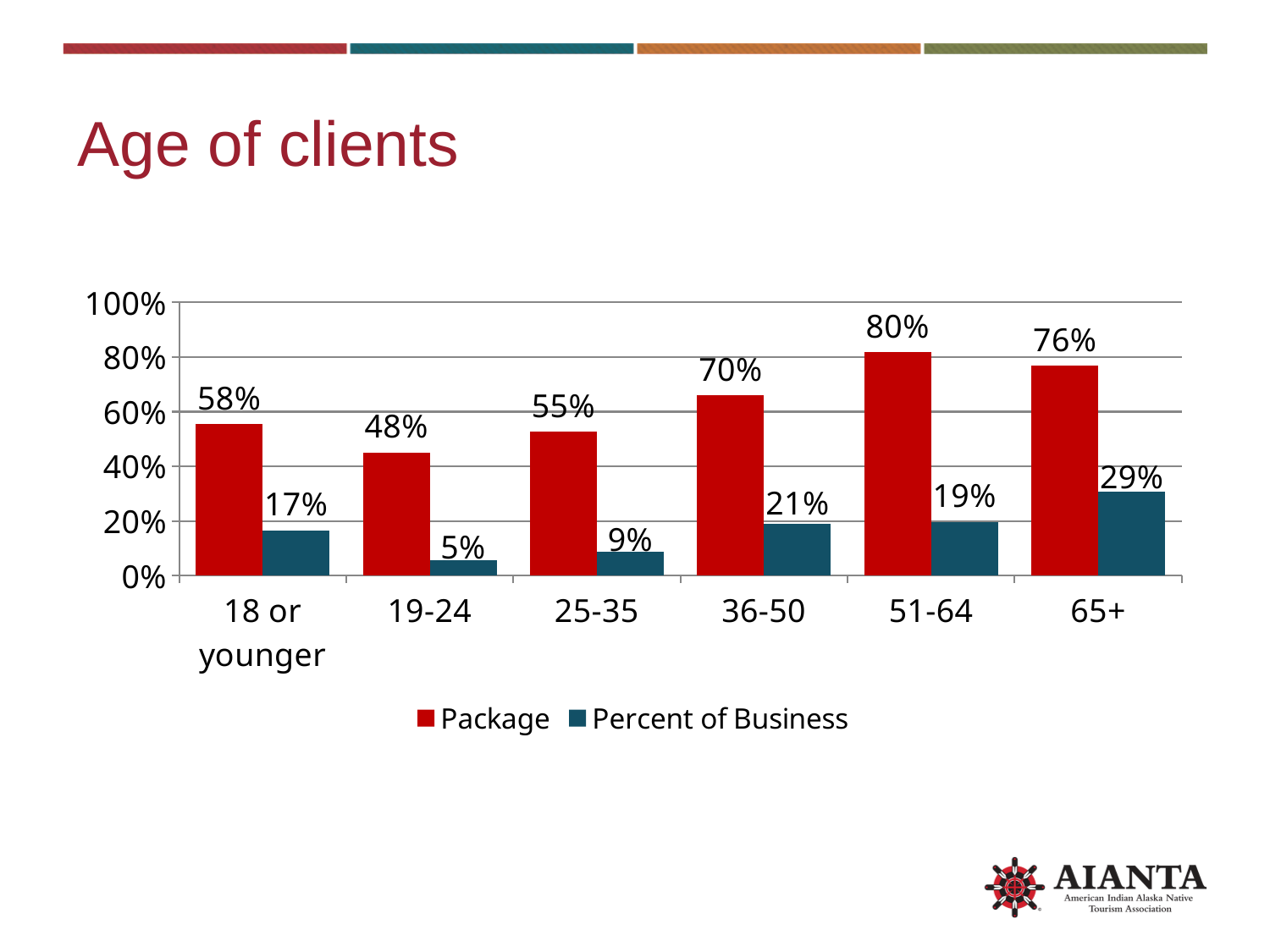
How many age groups are shown on the x axis? 6 What is the Percent of Business value for the 19-24 age group? 5% What is the difference between the Package value and the Percent of Business value for the 51-64 age group? 61% What is the title of the slide? Age of clients Which colour represents the Package series in the legend? Red What kind of chart is shown on the slide? Bar chart Which is larger, the Percent of Business value for 18 or younger or for 36-50? 36-50 What is the Percent of Business value for the 65+ age group? 29% Which age group has the lowest Percent of Business value? 19-24 What is the Package value for the 36-50 age group? 70% How many series does the legend list? 2 Which age group has the highest Package value? 51-64